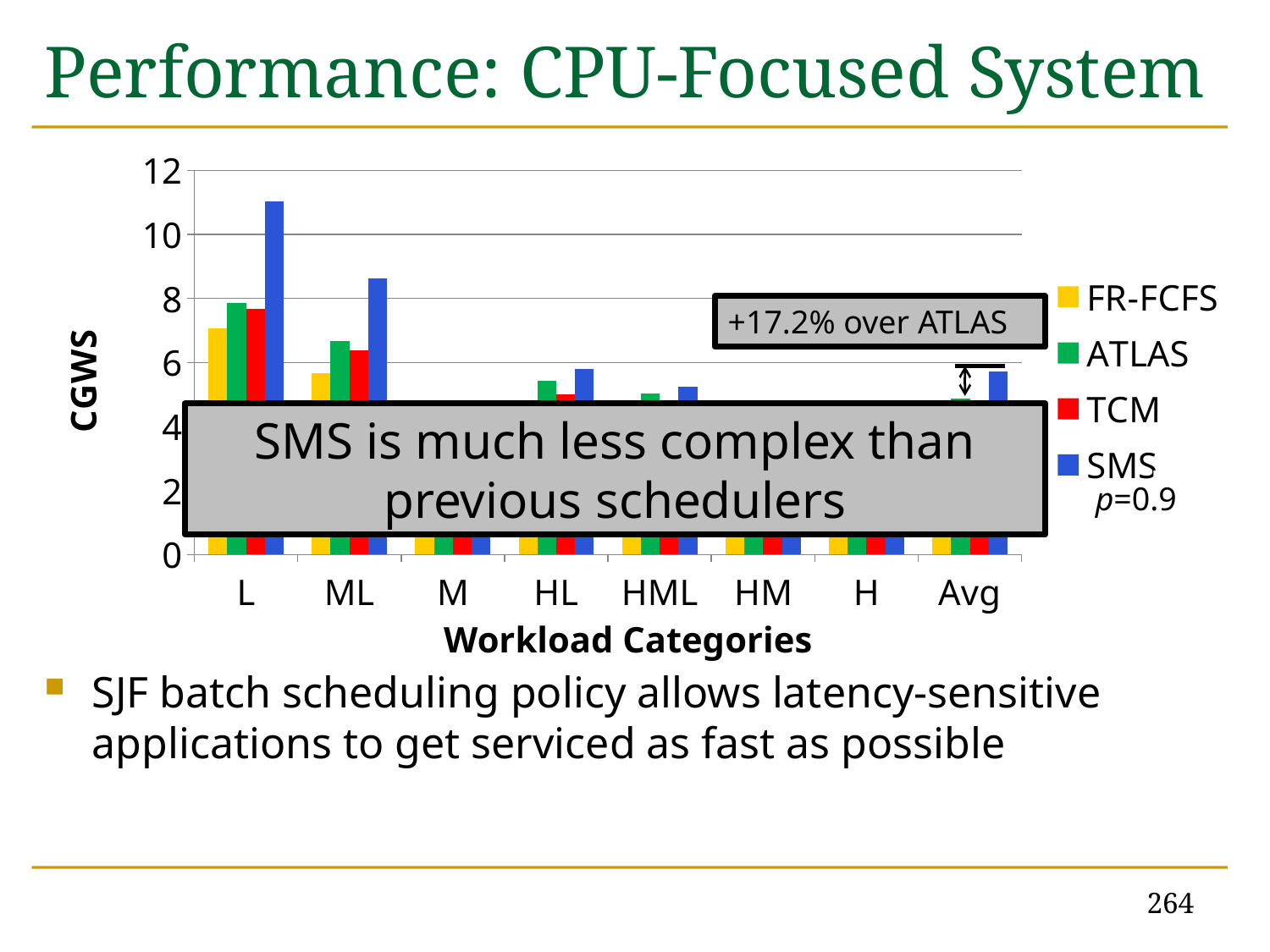
Is the SMS value for workload category L greater or less than 10? greater Is the FR-FCFS value for workload category L greater or less than 6? greater What is the label of the y axis? CGWS What improvement over ATLAS does the annotation on the chart state? +17.2% over ATLAS How many workload categories are shown on the x axis? 8 What kind of chart is shown on the slide? bar chart For which workload category is the SMS bar the tallest? L How many series does the legend list? 4 Is the SMS value for workload category ML greater or less than 8? greater For workload category L, which is larger: the SMS value or the FR-FCFS value? SMS